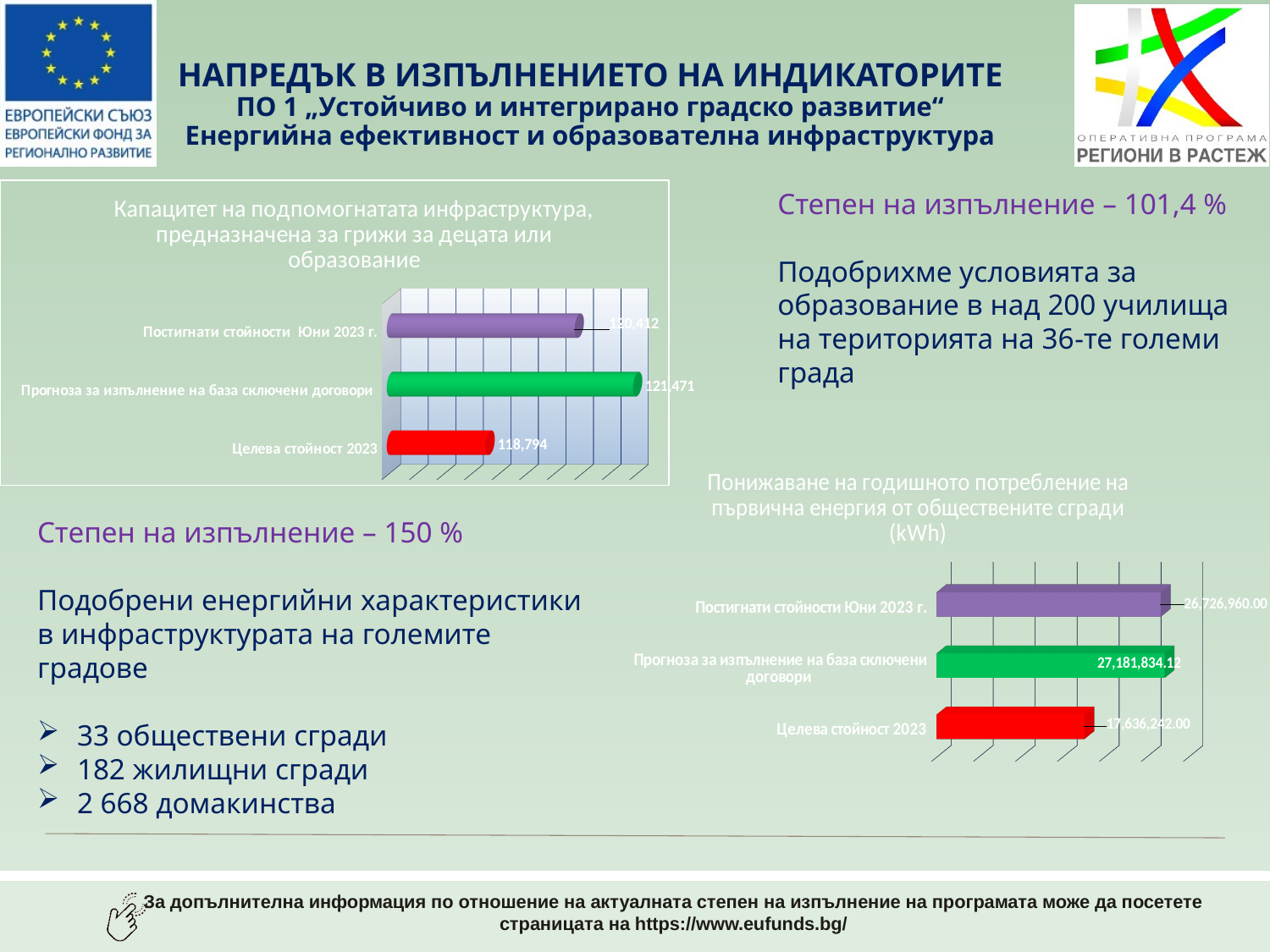
On the left chart (Капацитет на подпомогнатата инфраструктура), which category has the lowest value? Целева стойност 2023 On the right chart (Понижаване на годишното потребление на първична енергия), what is the value for Прогноза за изпълнение на база сключени договори? 27,181,834.12 On the left chart (Капацитет на подпомогнатата инфраструктура), what is the value for Целева стойност 2023? 118,794 On the right chart (Понижаване на годишното потребление на първична енергия), what is the difference between Прогноза за изпълнение на база сключени договори and Постигнати стойности Юни 2023 г.? 454,874.12 On the right chart (Понижаване на годишното потребление на първична енергия), what is the value for Постигнати стойности Юни 2023 г.? 26,726,960.00 On the right chart (Понижаване на годишното потребление на първична енергия), which category has the lowest value? Целева стойност 2023 On the right chart (Понижаване на годишното потребление на първична енергия), which is larger: Прогноза за изпълнение на база сключени договори or Постигнати стойности Юни 2023 г.? Прогноза за изпълнение на база сключени договори On the left chart (Капацитет на подпомогнатата инфраструктура), which category has the highest value? Прогноза за изпълнение на база сключени договори On the left chart (Капацитет на подпомогнатата инфраструктура), what is the difference between Прогноза за изпълнение на база сключени договори and Целева стойност 2023? 2,677 On the left chart (Капацитет на подпомогнатата инфраструктура), what is the value for Прогноза за изпълнение на база сключени договори? 121,471 On the left chart (Капацитет на подпомогнатата инфраструктура), how many bars are plotted? 3 What kind of chart is the right chart (Понижаване на годишното потребление на първична енергия)? Bar chart